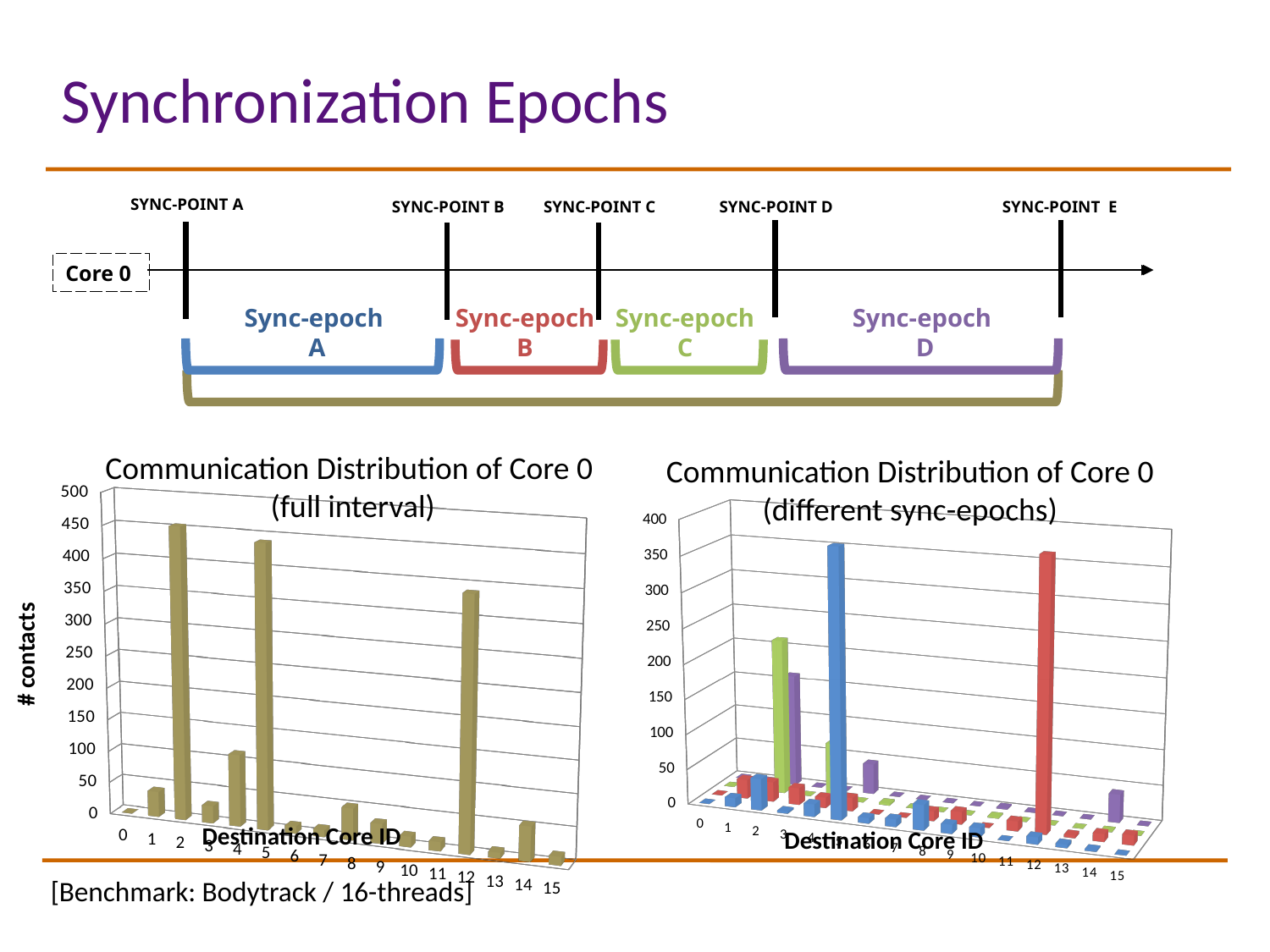
In the 'Communication Distribution of Core 0 (full interval)' chart, is the value for destination core 1 greater or less than 50? less What is the x-axis title of the 'Communication Distribution of Core 0 (different sync-epochs)' chart? Destination Core ID How many destination core IDs are shown on the x axis of the 'Communication Distribution of Core 0 (full interval)' chart? 16 What kind of chart is the 'Communication Distribution of Core 0 (full interval)' chart? bar chart In the 'Communication Distribution of Core 0 (full interval)' chart, is the value for destination core 12 greater or less than 300? greater In the 'Communication Distribution of Core 0 (full interval)' chart, is the value for destination core 2 greater or less than 400? greater In the 'Communication Distribution of Core 0 (full interval)' chart, which has more contacts, destination core 5 or destination core 4? destination core 5 What is the label on the vertical axis of the 'Communication Distribution of Core 0 (full interval)' chart? # contacts In the 'Communication Distribution of Core 0 (full interval)' chart, which has more contacts, destination core 2 or destination core 12? destination core 2